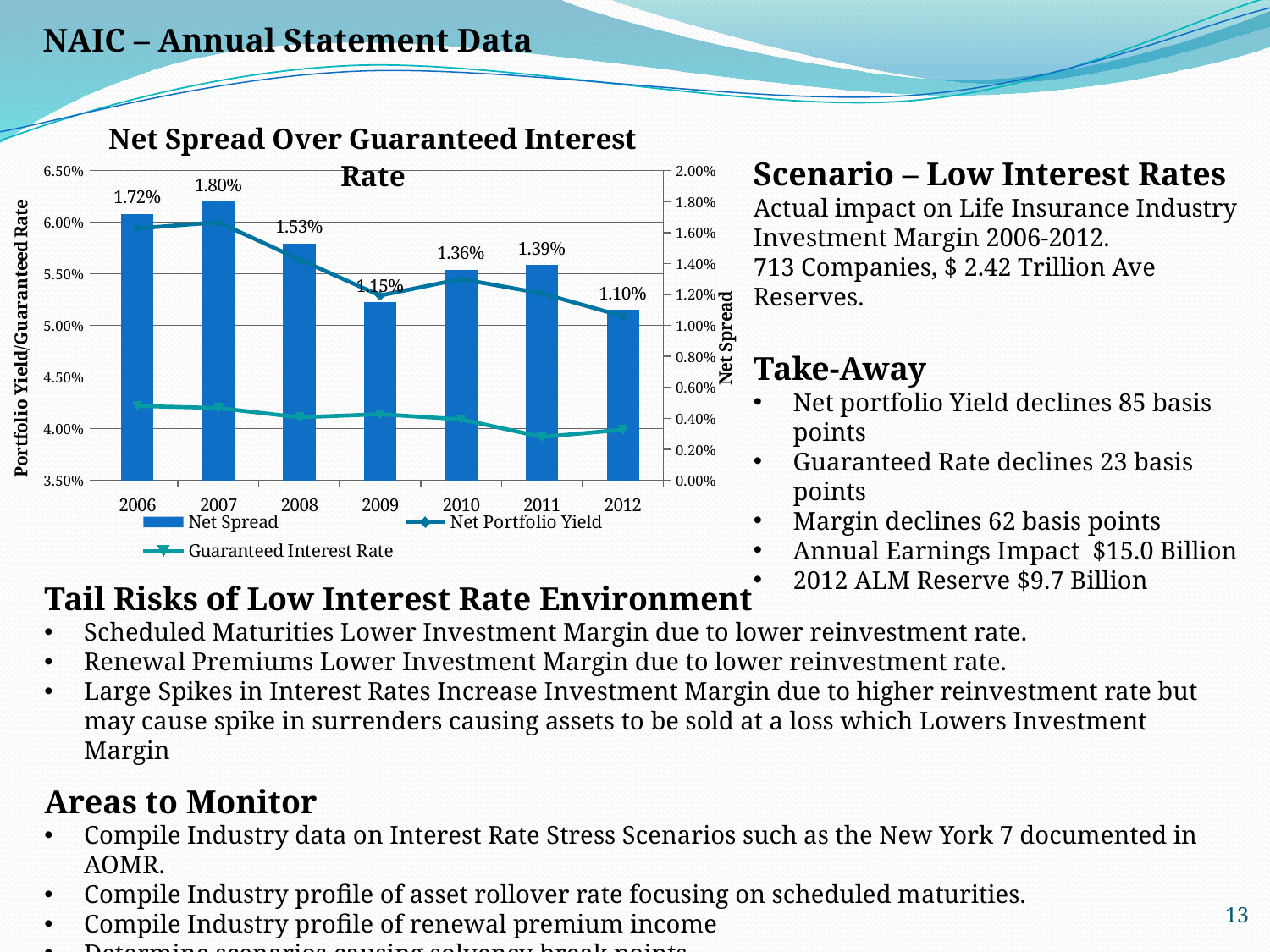
How many series does the chart legend list? 3 What is the Net Spread value for 2009? 1.15% What is the title of the chart? Net Spread Over Guaranteed Interest Rate Is the Guaranteed Interest Rate for 2012 greater or less than 4.50%? less What is the Net Spread value for 2012? 1.10% What is the difference between the Net Spread in 2007 and in 2012? 0.70% Is the Net Portfolio Yield for 2006 greater or less than 5.50%? greater What is the Net Spread value for 2007? 1.80% Which year has the lowest Net Spread? 2012 Which year has the highest Net Spread? 2007 Which year has a larger Net Spread, 2010 or 2011? 2011 How many years are shown on the x axis of the chart? 7